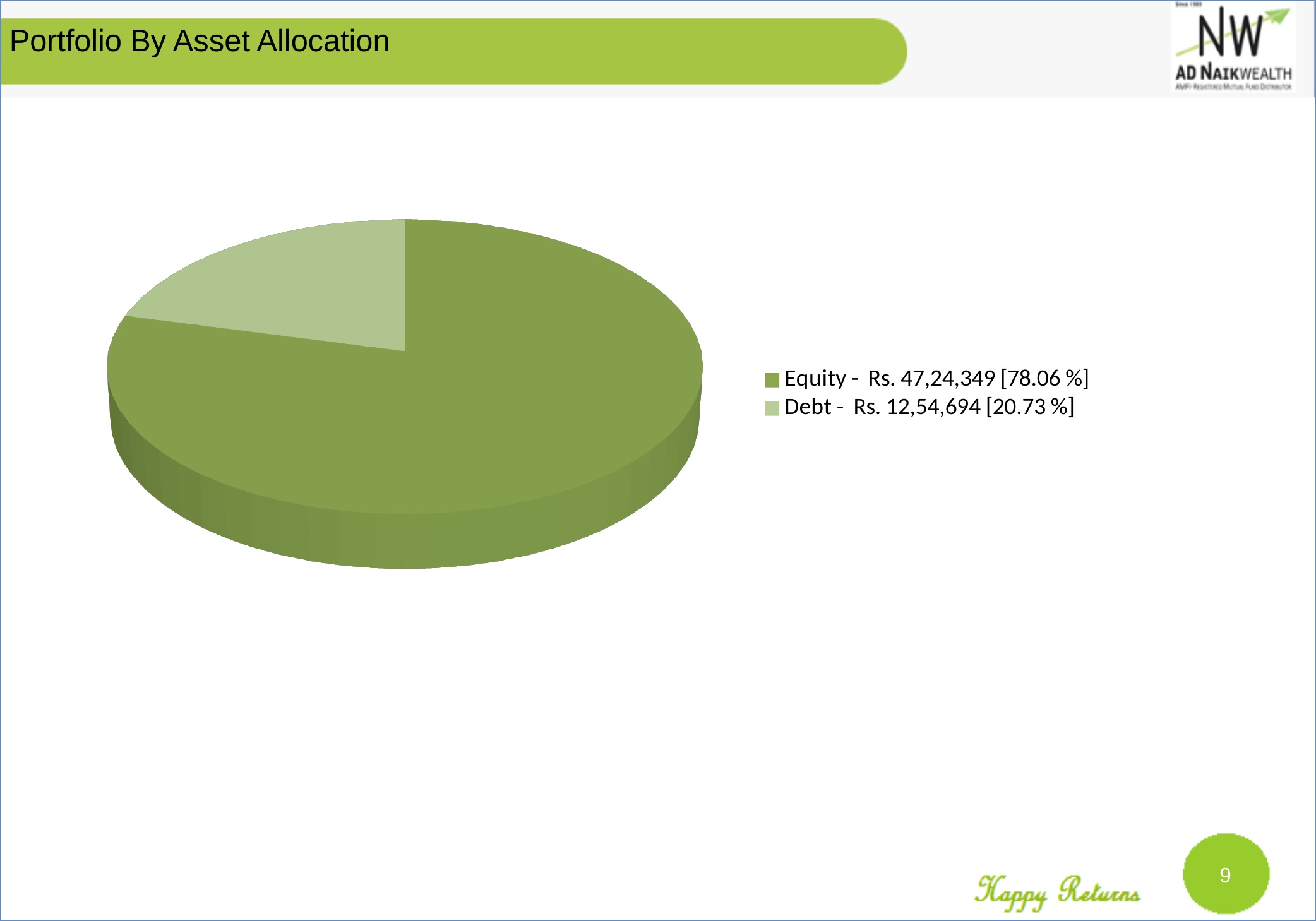
Which is larger, the Equity value or the Debt value? Equity Which asset class has the largest slice of the pie? Equity How many entries does the legend list? 2 What share of the pie does Equity represent? 78.06 % Which asset class has the smallest slice of the pie? Debt What is the title of the slide containing the pie chart? Portfolio By Asset Allocation What is the value shown for Debt in the legend? Rs. 12,54,694 What kind of chart is shown on the slide? Pie chart What share of the pie does Debt represent? 20.73 % How many slices does the pie chart have? 2 What is the difference in percentage points between the Equity share and the Debt share? 57.33 What is the value shown for Equity in the legend? Rs. 47,24,349